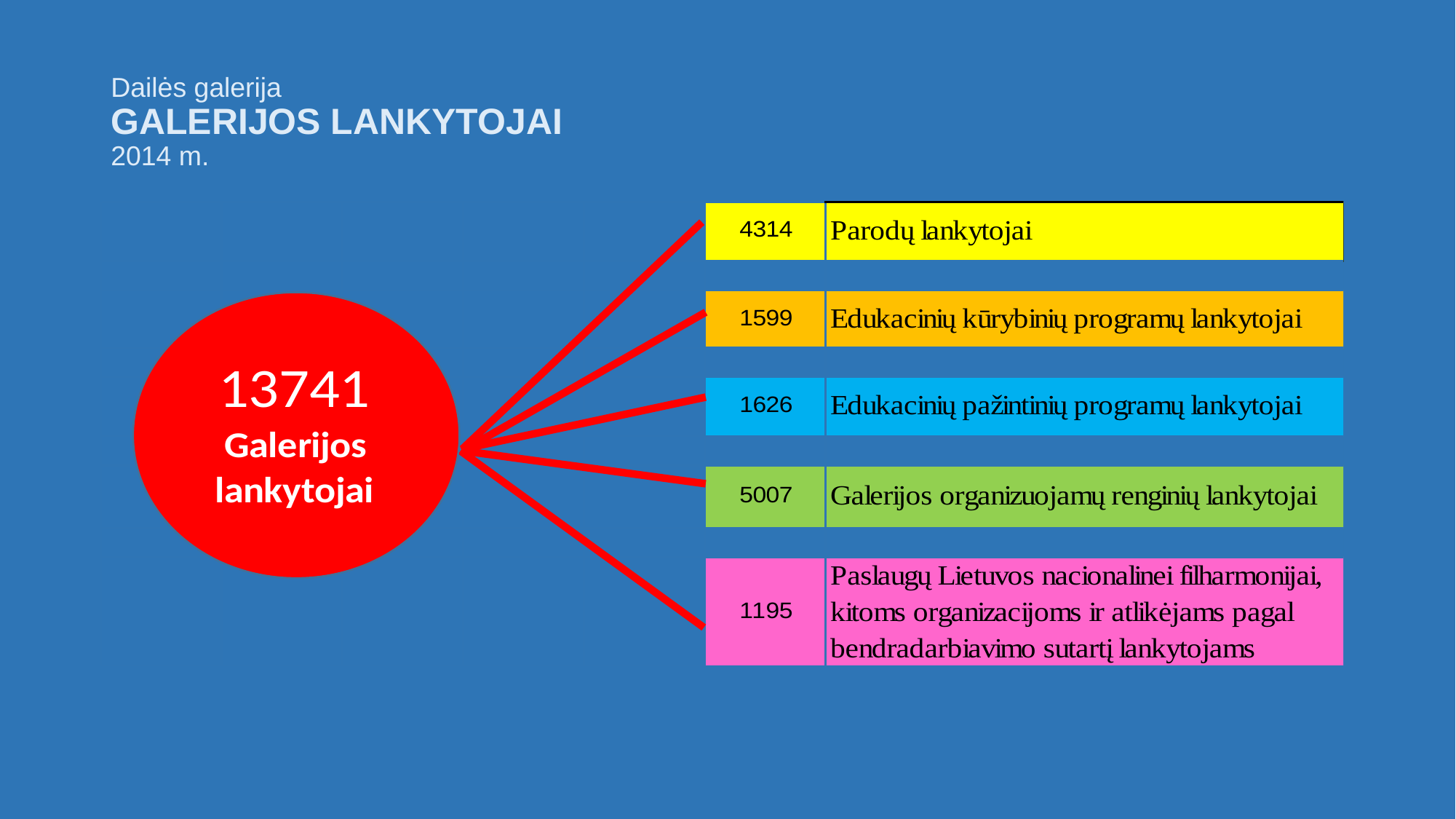
Which visitor category has the lowest value? Paslaugų Lietuvos nacionalinei filharmonijai, kitoms organizacijoms ir atlikėjams pagal bendradarbiavimo sutartį lankytojams How many visitor categories branch out from the red circle? 5 What is the value shown for Galerijos organizuojamų renginių lankytojai? 5007 How many visitors are shown for Parodų lankytojai? 4314 What is the difference between the values for Edukacinių pažintinių programų lankytojai and Edukacinių kūrybinių programų lankytojai? 27 What colour is the box for Parodų lankytojai? Yellow What is the difference between the values for Galerijos organizuojamų renginių lankytojai and Parodų lankytojai? 693 What is the value shown for Edukacinių kūrybinių programų lankytojai? 1599 Which visitor category has the highest value? Galerijos organizuojamų renginių lankytojai What is the sum of the five visitor category values? 13741 Which is larger: the value for Edukacinių pažintinių programų lankytojai or Edukacinių kūrybinių programų lankytojai? Edukacinių pažintinių programų lankytojai What total number of gallery visitors (Galerijos lankytojai) is shown in the red circle? 13741